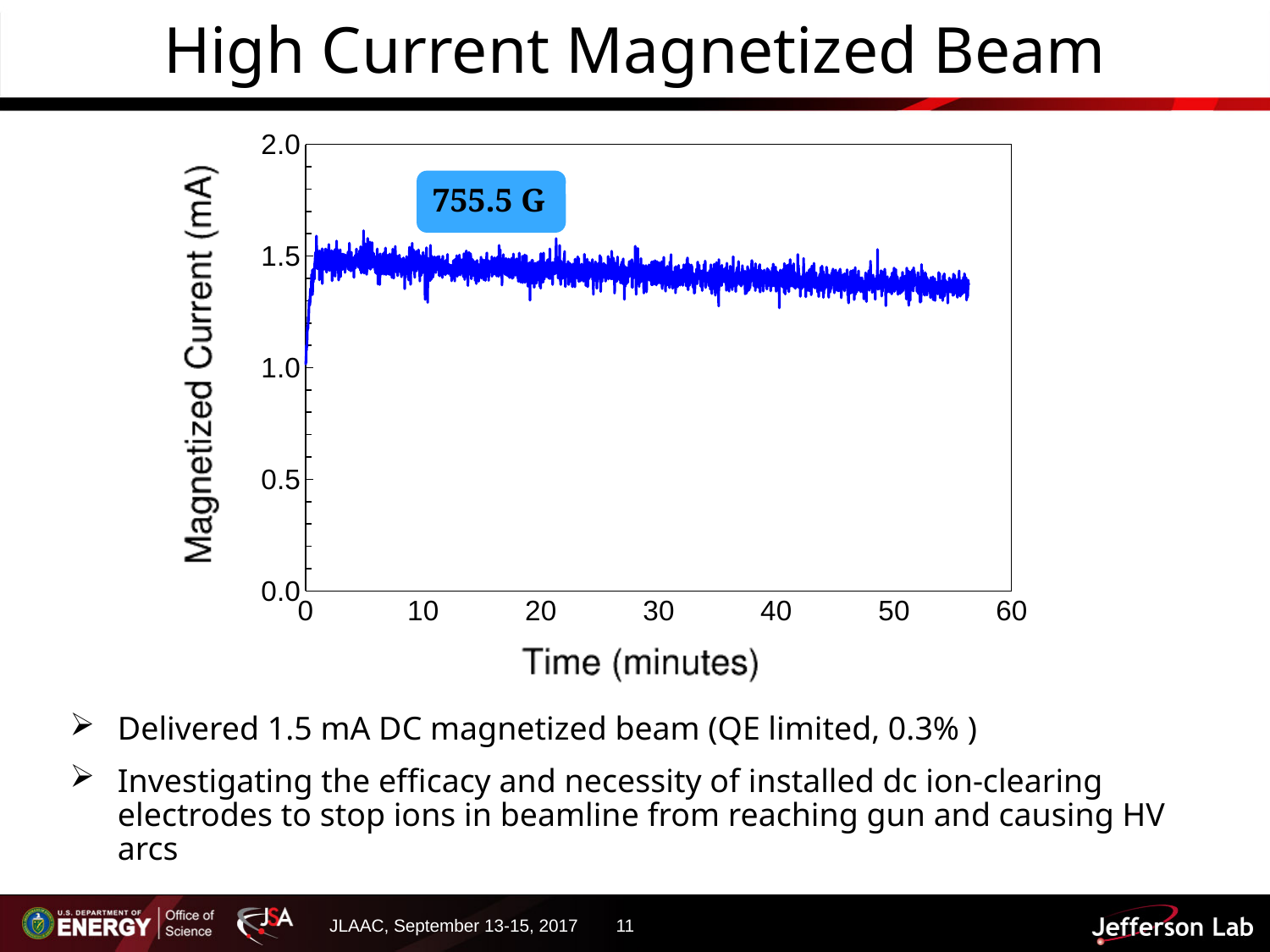
Is the magnetized current at 40 minutes greater or less than 1.0 mA? greater Does the magnetized current rise or fall between 10 minutes and 50 minutes? fall What is the highest value shown on the y axis of the chart? 2.0 Is the magnetized current at 5 minutes larger or smaller than at 55 minutes? larger Is the magnetized current at 50 minutes greater or less than 0.5 mA? greater What kind of chart is shown on the slide? line chart How many data series are plotted on the chart? 1 Is the magnetized current at 20 minutes greater or less than 2.0 mA? less What magnetic field value is annotated on the chart? 755.5 G